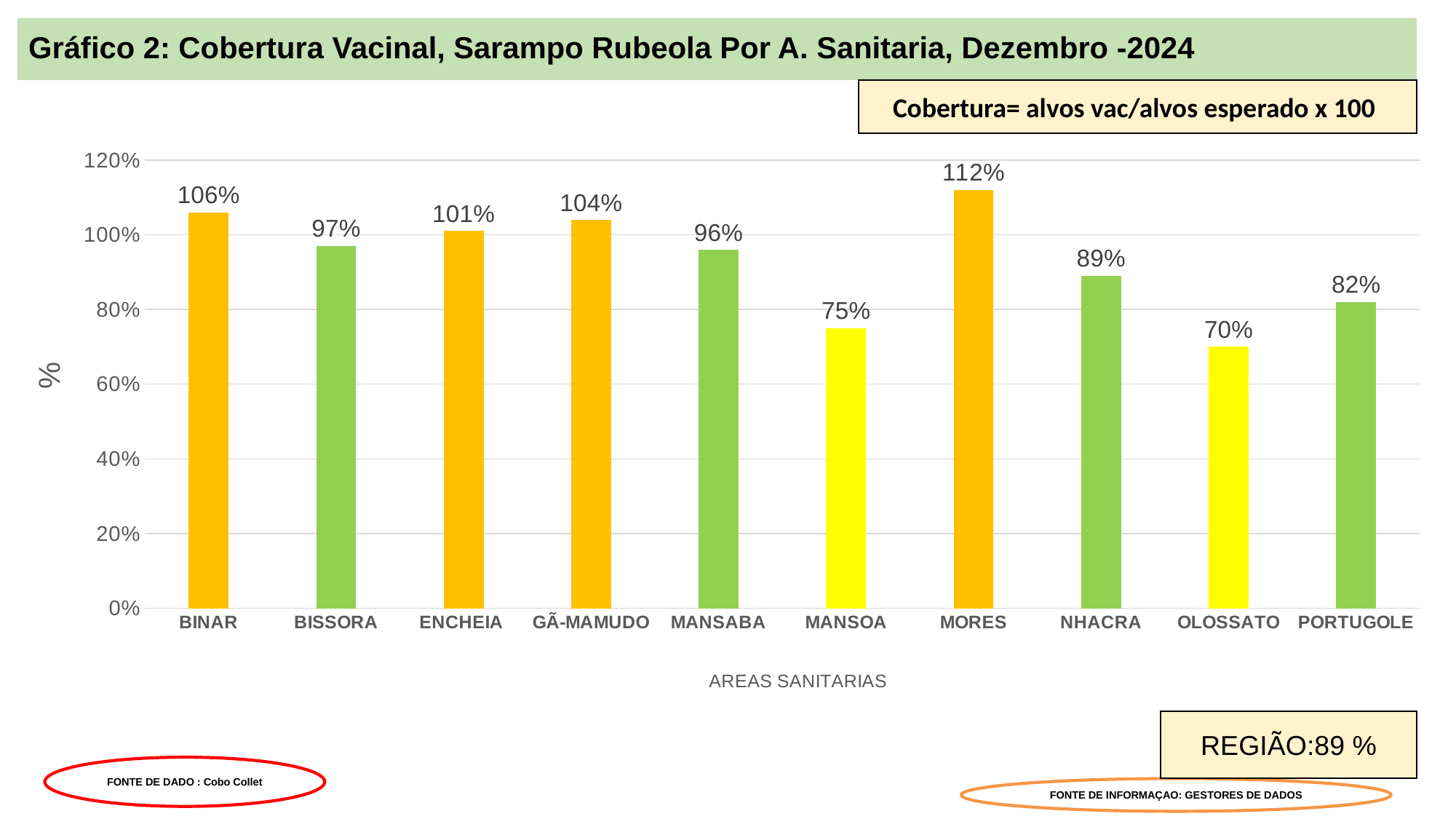
What is the title of the chart? Gráfico 2: Cobertura Vacinal, Sarampo Rubeola Por A. Sanitaria, Dezembro -2024 What is the vaccination coverage value for OLOSSATO? 70% What is the vaccination coverage value for GÃ-MAMUDO? 104% Which area sanitaria has the highest coverage? MORES How many areas sanitarias are shown on the x axis? 10 Is the value for MANSOA greater or less than 80%? less Which has a higher coverage, MANSABA or NHACRA? MANSABA What is the vaccination coverage value for MORES? 112% What is the label of the x axis? AREAS SANITARIAS What kind of chart is shown on the slide? bar chart Which area sanitaria has the lowest coverage? OLOSSATO What is the difference between the coverage for BINAR and the coverage for BISSORA? 9%